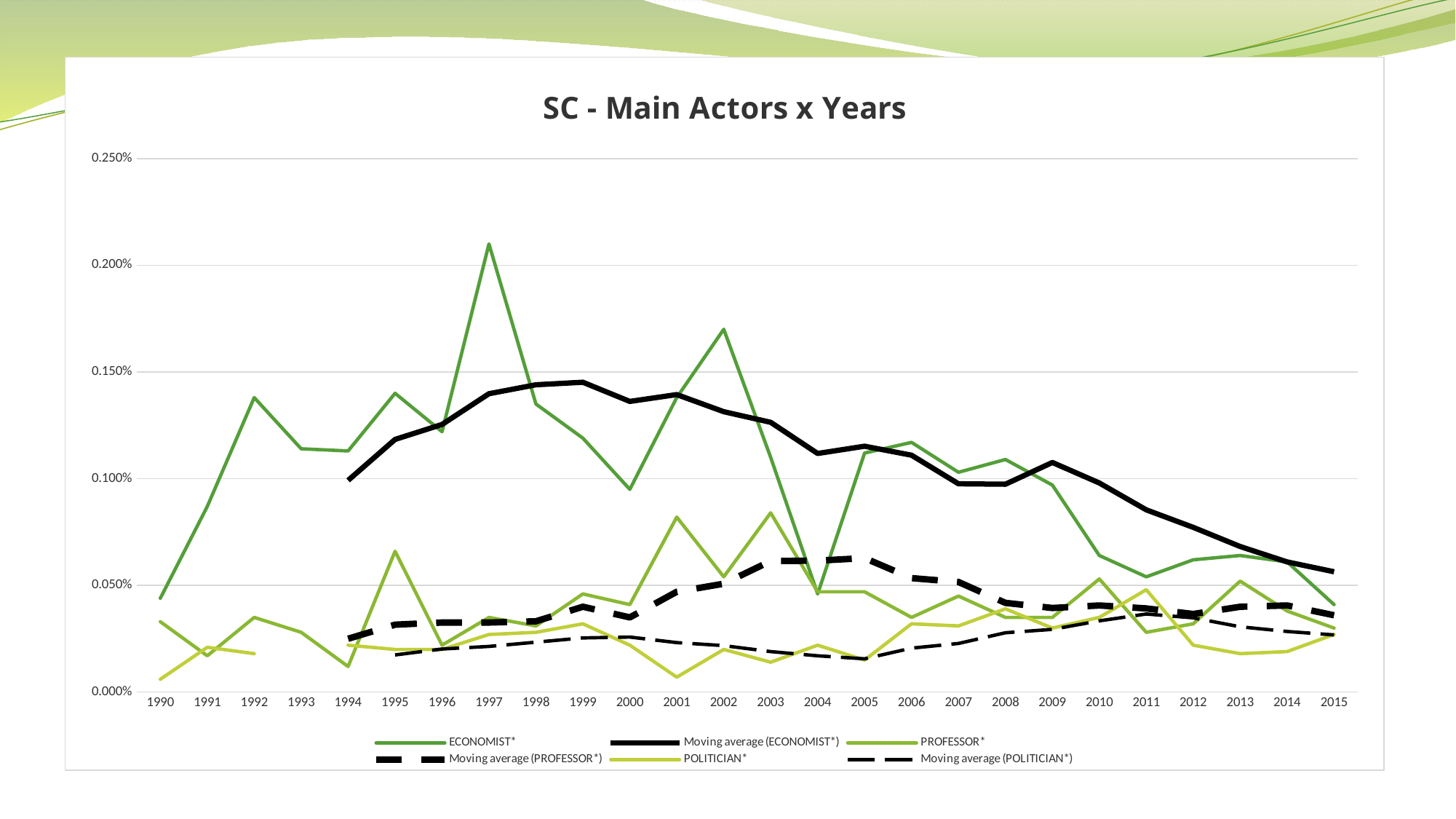
Is the value for ECONOMIST* in 1997 greater or less than 0.200%? greater Is the value for ECONOMIST* in 2010 greater or less than 0.050%? greater Which is larger for ECONOMIST*: the value in 1997 or the value in 2002? 1997 How many series does the legend list? 6 Does the Moving average (ECONOMIST*) line rise or fall from 1999 to 2015? fall How many years are shown on the x axis? 26 Which series is drawn as a solid black line? Moving average (ECONOMIST*) What kind of chart is shown on the slide? line chart Is the value for POLITICIAN* in 1990 greater or less than 0.050%? less In which year does the ECONOMIST* series reach its highest value? 1997 What is the title of the chart? SC - Main Actors x Years